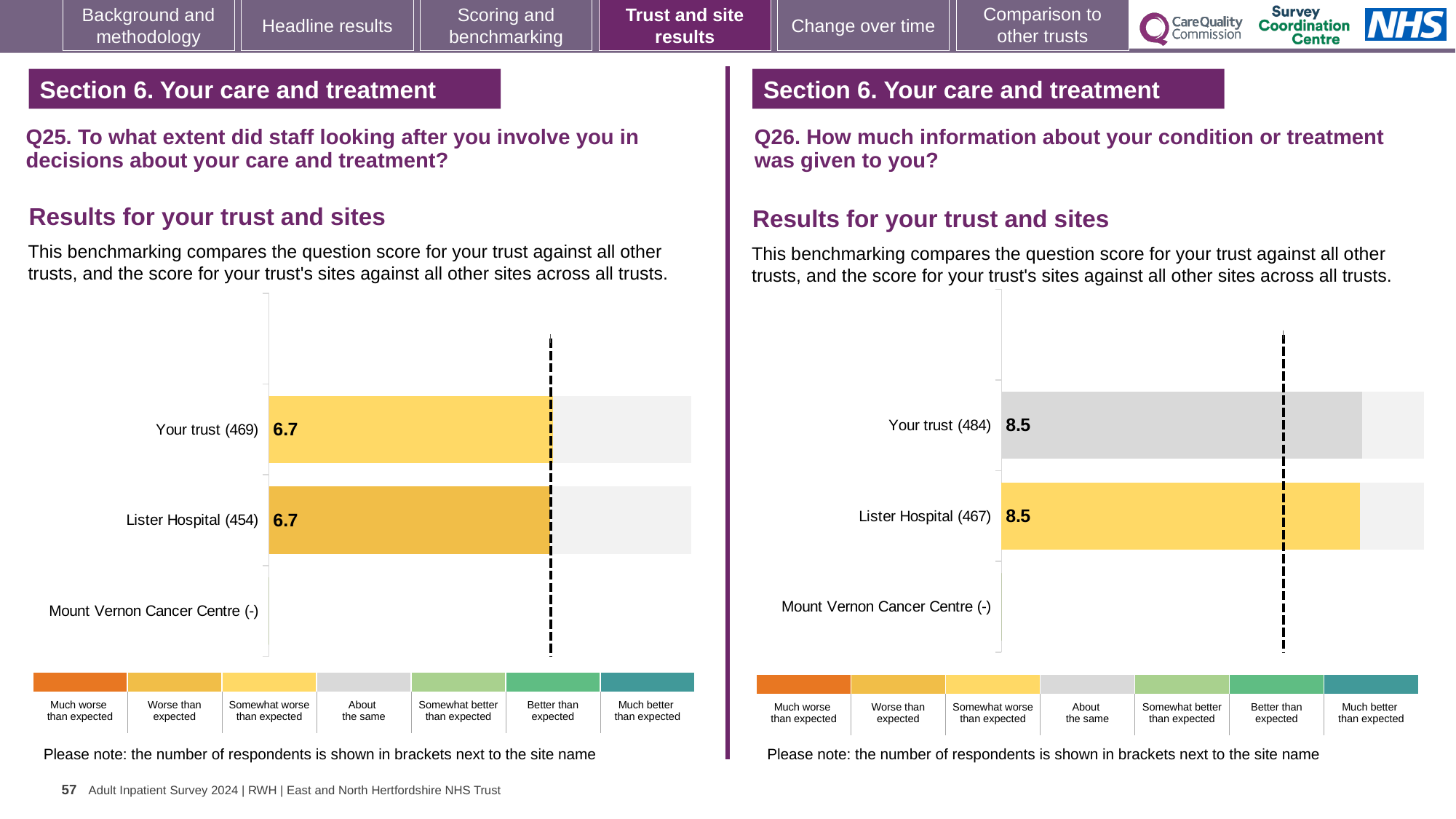
In the Q26 chart on the right, what is the difference between the scores for Your trust and Lister Hospital? 0.0 In the Q26 chart on the right, which benchmarking category does the colour of the Your trust bar correspond to? About the same How many site/trust categories are listed on the y axis of the Q26 chart on the right? 3 In the Q25 chart on the left, how many respondents are shown in brackets for Lister Hospital? 454 In the Q25 chart on the left, what is the score for Lister Hospital? 6.7 In the Q25 chart on the left, what is the score for Your trust? 6.7 In the Q25 chart on the left, what is the difference between the scores for Your trust and Lister Hospital? 0.0 In the Q26 chart on the right, how many respondents are shown in brackets for Your trust? 484 In the Q25 chart on the left, which benchmarking category does the colour of the Lister Hospital bar correspond to? Worse than expected In the Q26 chart on the right, what is the score for Lister Hospital? 8.5 What kind of chart is used for the Q25 results on the left? Bar chart In the Q26 chart on the right, what is the score for Your trust? 8.5